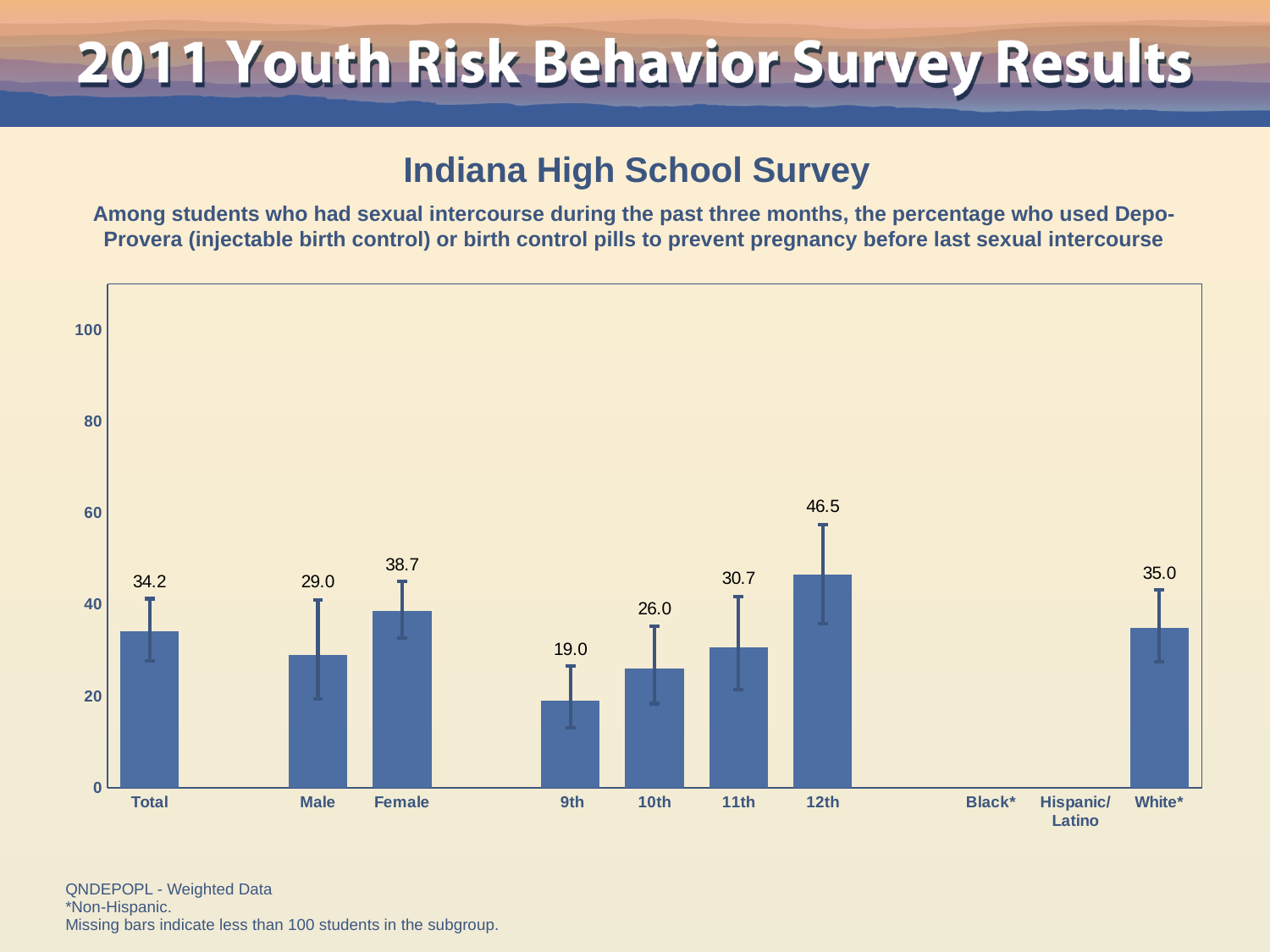
What is the value for Total? 34.2 What is the value for White*? 35.0 What is the value for Female? 38.7 How many categories on the x axis have a bar plotted? 8 What is the value for 12th grade? 46.5 Which is larger, the value for 10th or the value for 11th? 11th Which category with a bar has the lowest value? 9th Which category has the highest value? 12th Is the value for 12th greater or less than 40? greater Do the values rise or fall from 9th grade to 12th grade? rise What is the difference between the Female and Male values? 9.7 What kind of chart is shown? bar chart